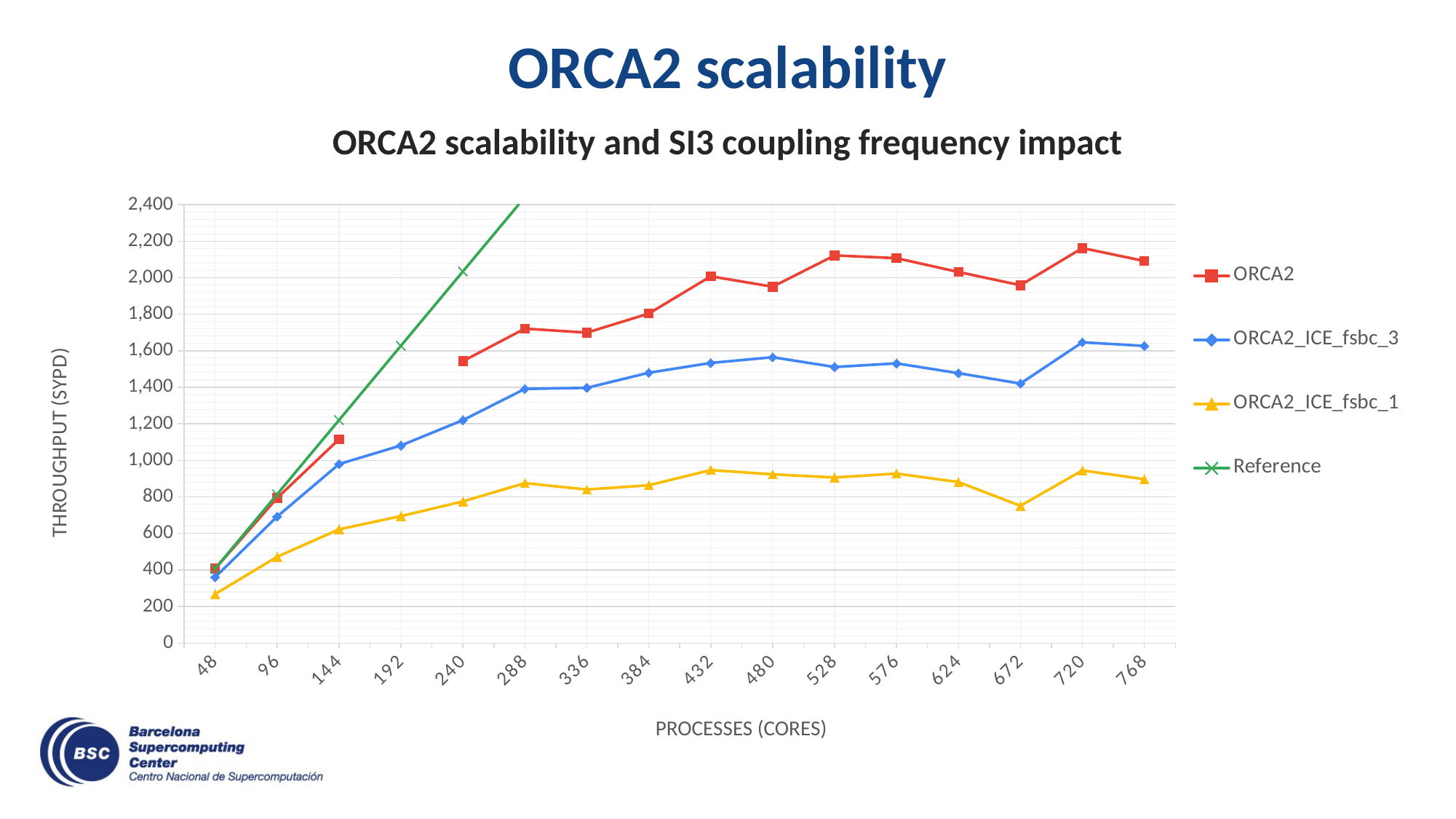
What kind of chart is shown on the slide? line chart How many process counts (cores) are marked along the x axis? 16 Which series has the lowest throughput across the plotted core counts? ORCA2_ICE_fsbc_1 Is the ORCA2_ICE_fsbc_1 value at 48 cores greater or less than 400? less Does the ORCA2_ICE_fsbc_1 throughput rise or fall from 48 to 144 cores? rise Is the ORCA2 value at 768 cores greater or less than 2,000? greater At 432 cores, which series has the higher throughput, ORCA2 or ORCA2_ICE_fsbc_3? ORCA2 What is the title of the chart? ORCA2 scalability and SI3 coupling frequency impact How many series does the legend list? 4 Is the ORCA2 value at 240 cores greater or less than 1,400? greater What is the label of the y axis? THROUGHPUT (SYPD)